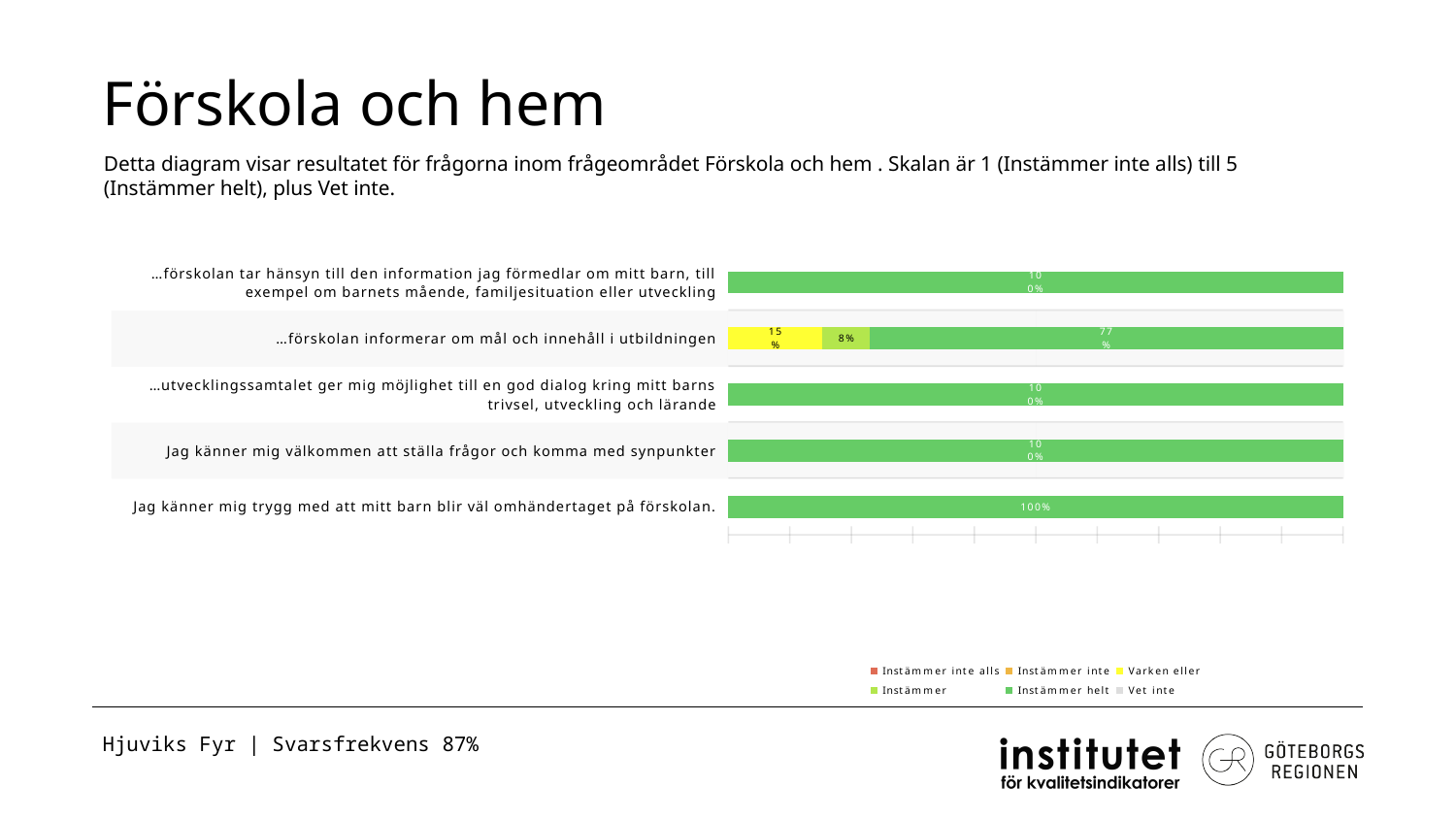
How many series does the legend list? 6 What is the Instämmer value for "…förskolan informerar om mål och innehåll i utbildningen"? 8% What is the Instämmer helt value for "Jag känner mig trygg med att mitt barn blir väl omhändertaget på förskolan."? 100% What is the total of the stacked bar for "…förskolan informerar om mål och innehåll i utbildningen"? 100% What is the title of the slide containing the chart? Förskola och hem How many questions (categories) are plotted in the chart? 5 What is the Instämmer helt value for "…förskolan informerar om mål och innehåll i utbildningen"? 77% Which question has the lowest Instämmer helt share? …förskolan informerar om mål och innehåll i utbildningen What is the difference between the Instämmer helt value and the Varken eller value for "…förskolan informerar om mål och innehåll i utbildningen"? 62% What kind of chart is shown on the slide? Stacked bar chart What is the Varken eller value for "…förskolan informerar om mål och innehåll i utbildningen"? 15% Which is larger for "…förskolan informerar om mål och innehåll i utbildningen": the Varken eller value or the Instämmer value? Varken eller